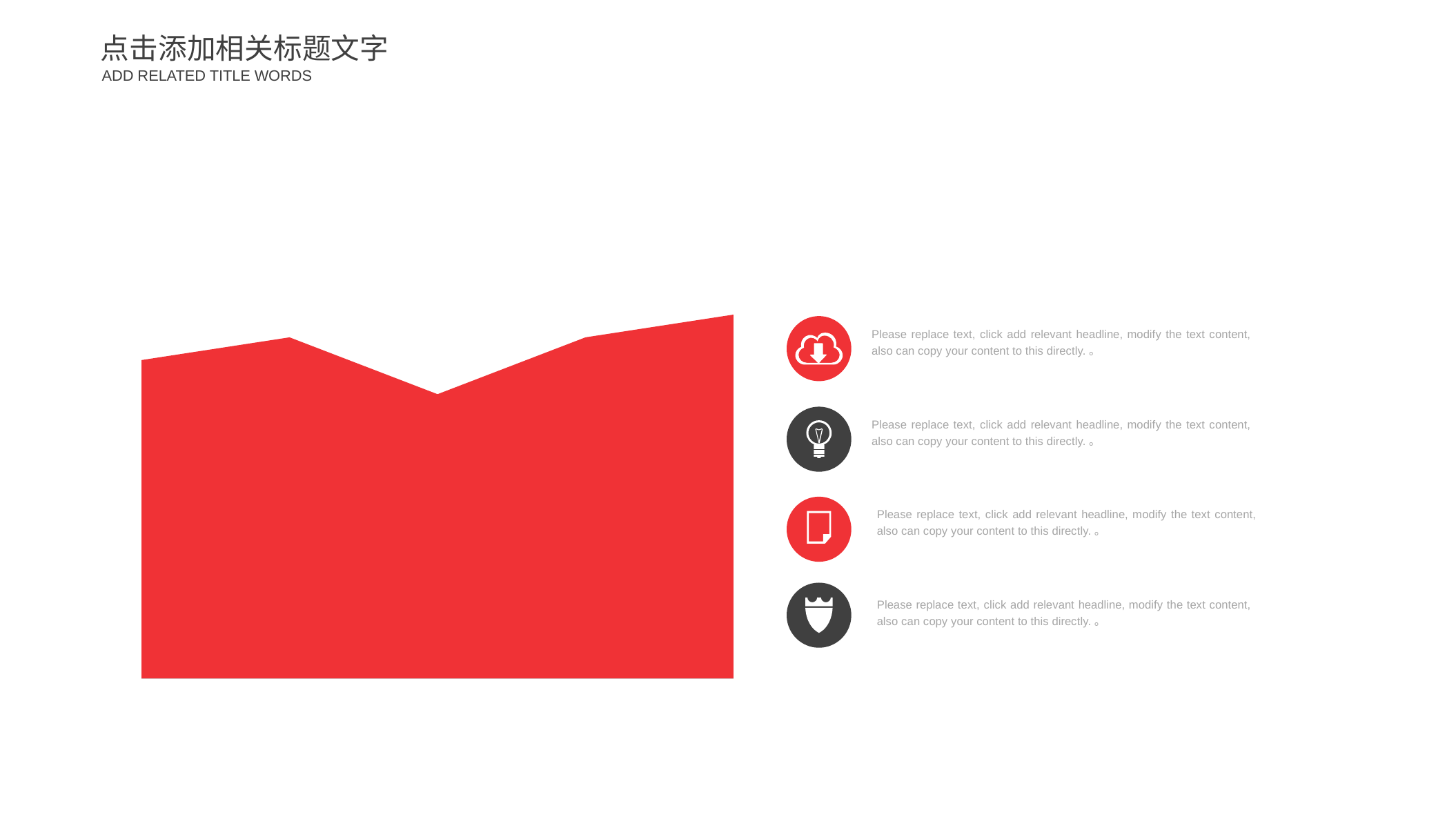
How many data points does the area chart's outline have? 5 What kind of chart is shown on the left of the slide? area chart Is the rightmost point of the area chart higher or lower than the leftmost point? higher Which point of the area chart is the lowest: the first, the third, or the last? the third Which point of the area chart is the highest: the first, the third, or the last? the last What colour is the filled area in the chart? red Does the area chart show a legend? no